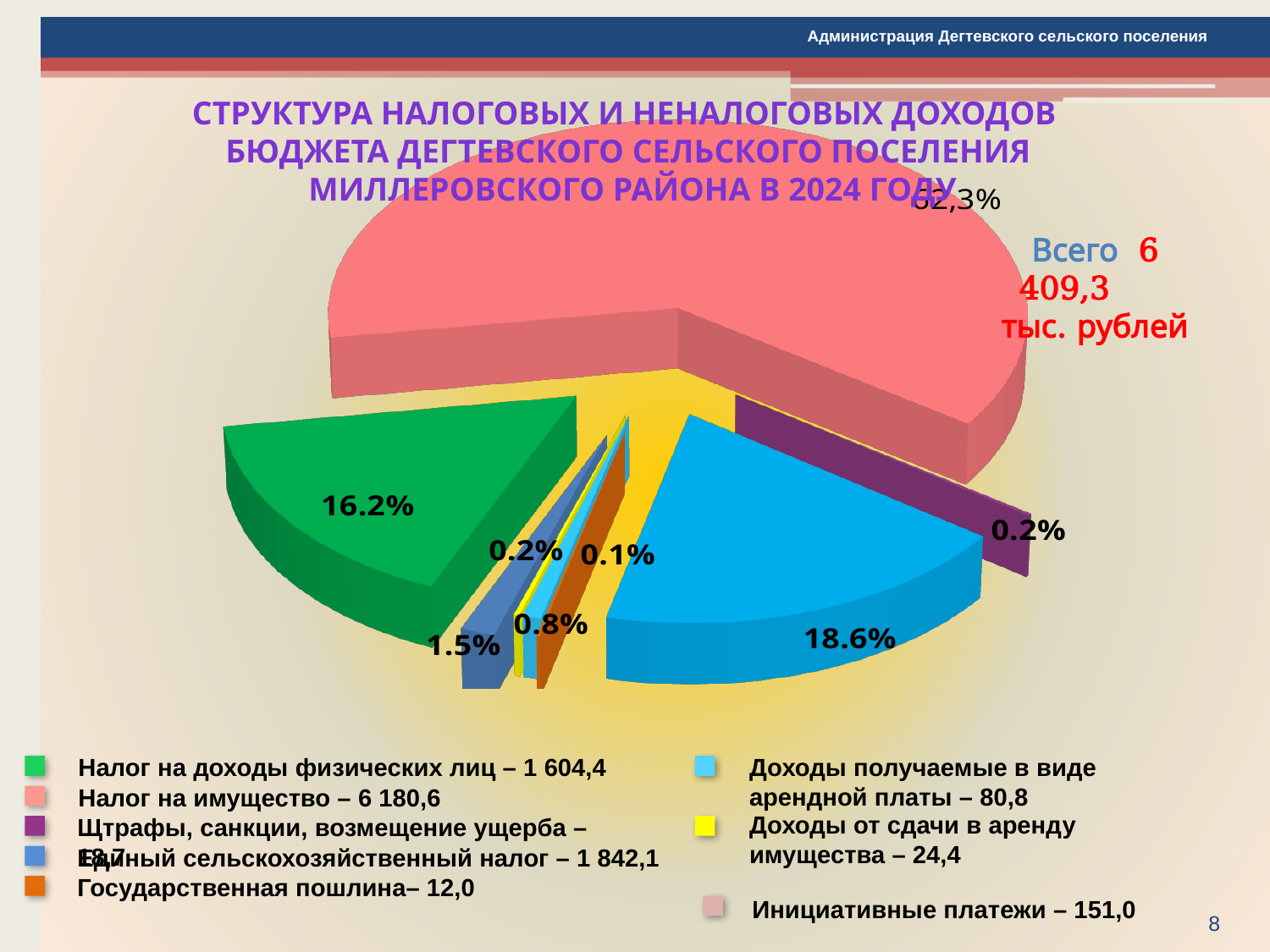
Which slice is larger: the green slice at 16.2% or the light blue slice at 18.6%? the light blue slice (18.6%) Which category has the largest slice of the pie? Налог на имущество What is the difference in percentage points between the light blue slice (18.6%) and the green slice (16.2%)? 2.4 What percentage is shown for the green slice (Налог на доходы физических лиц)? 16.2% What value is given in the legend for Инициативные платежи? 151,0 What total amount (Всего) is stated next to the pie chart? 6 409,3 тыс. рублей What percentage is shown for the purple slice (Штрафы, санкции, возмещение ущерба)? 0.2% What kind of chart is shown on the slide? pie chart How many categories are listed in the legend below the chart? 8 What value is given in the legend for Налог на доходы физических лиц? 1 604,4 What is the smallest percentage label shown on the pie? 0.1%